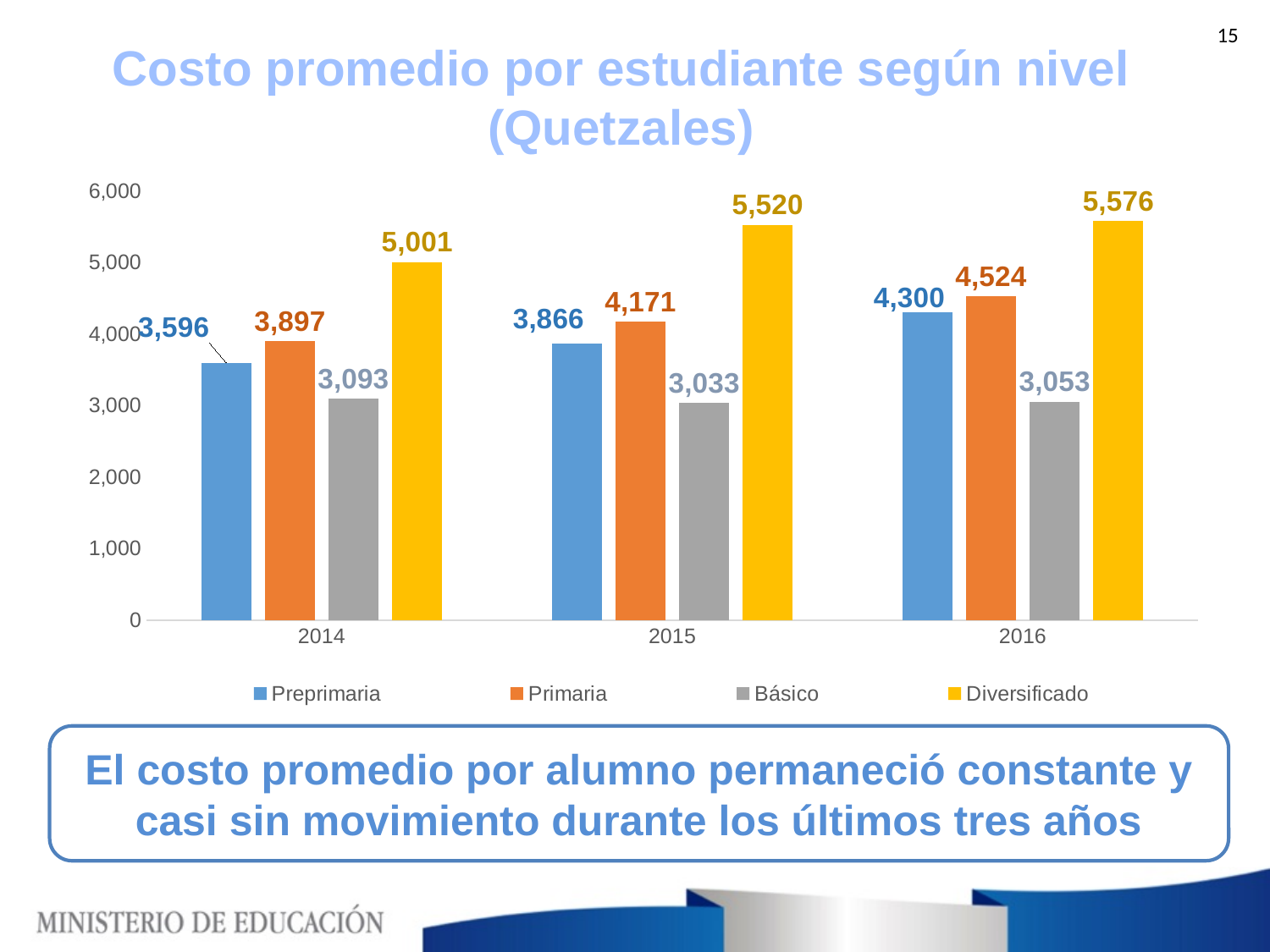
What is the difference between Primaria and Preprimaria in 2016? 224 What is the value for Básico in 2016? 3,053 Which level has the highest value in 2016? Diversificado How many series does the legend list? 4 Which is larger, Primaria in 2015 or Preprimaria in 2016? Preprimaria in 2016 How many years are shown on the x axis? 3 What is the value for Preprimaria in 2014? 3,596 What is the value for Diversificado in 2015? 5,520 What is the difference between the Diversificado value in 2016 and in 2014? 575 Does the Preprimaria value rise or fall from 2014 to 2016? Rise Which level has the lowest value in 2015? Básico What kind of chart is shown on the slide? Bar chart